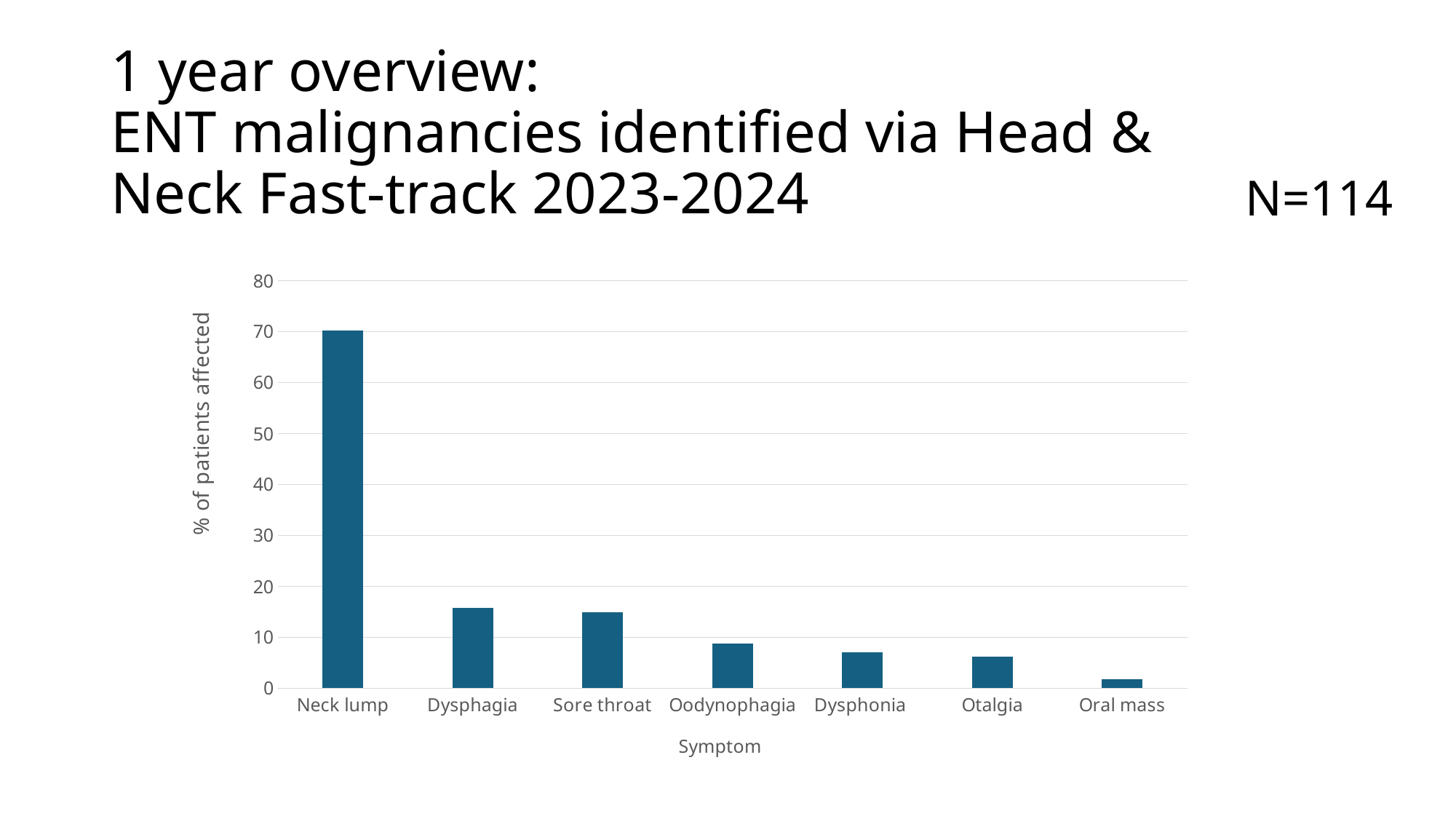
Do the values rise or fall moving from left to right along the x axis? fall What kind of chart is shown on the slide? bar chart Is the value for Neck lump greater or less than 60? greater Which is larger, the value for Neck lump or the value for Dysphagia? Neck lump Is the value for Dysphonia greater or less than 10? less Is the value for Oral mass greater or less than 10? less Which symptom has the lowest percentage of patients affected? Oral mass Which symptom has the highest percentage of patients affected? Neck lump How many symptoms are plotted on the x axis? 7 What is the label on the y axis of the chart? % of patients affected